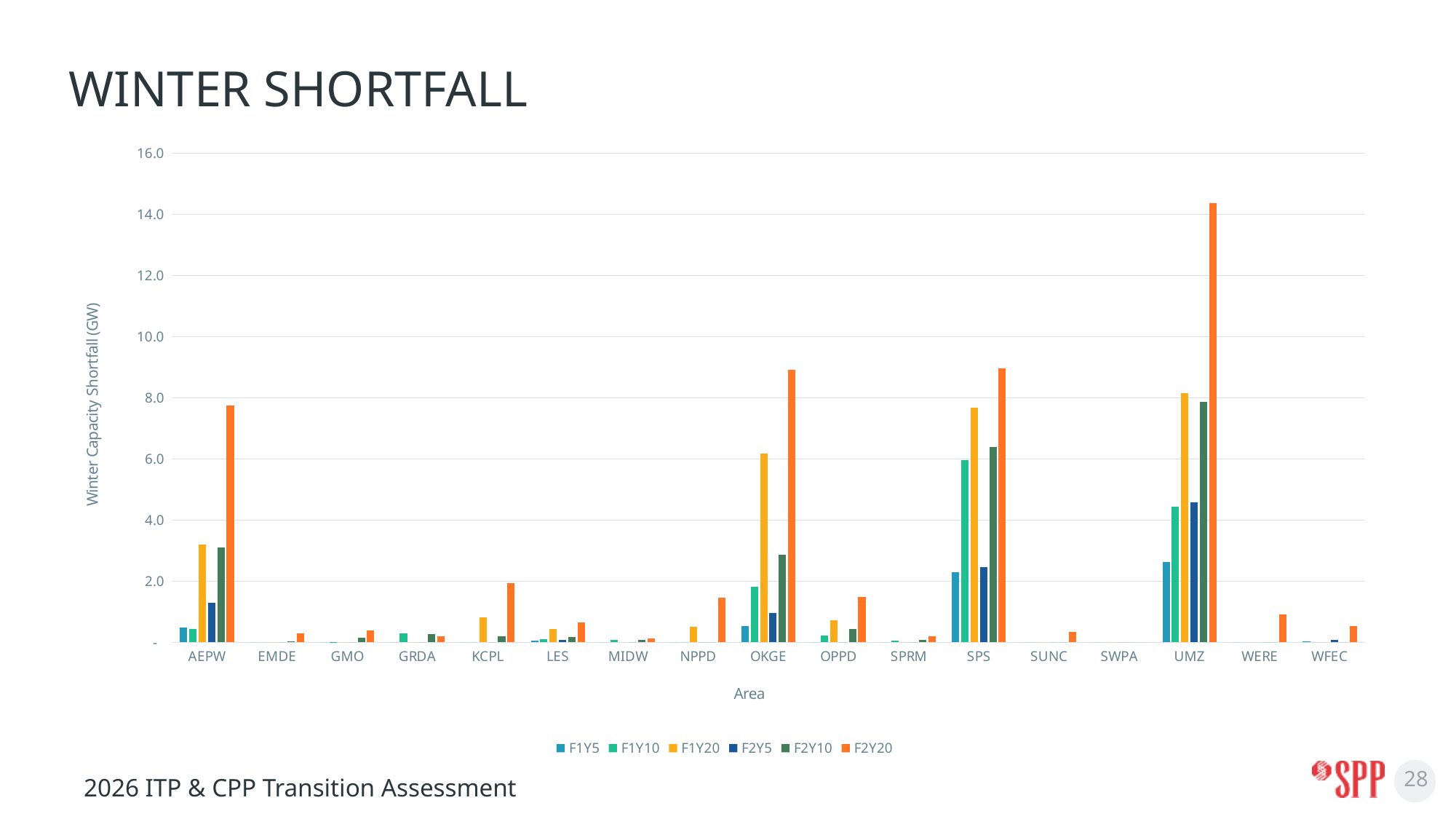
Which is larger, the F1Y10 value for SPS or the F1Y10 value for UMZ? SPS What is the label of the y axis? Winter Capacity Shortfall (GW) Is the F2Y20 value for SPS greater or less than 10.0? less Is the F2Y20 value for UMZ greater or less than 12.0? greater How many areas are shown along the x axis? 17 What kind of chart is shown on the slide? Bar chart Which is larger, the F2Y20 value for AEPW or the F2Y20 value for OKGE? OKGE Which area has the highest F1Y10 winter capacity shortfall? SPS Is the F2Y20 value for AEPW greater or less than 6.0? greater Which area has the highest F2Y20 winter capacity shortfall? UMZ How many series does the legend list? 6